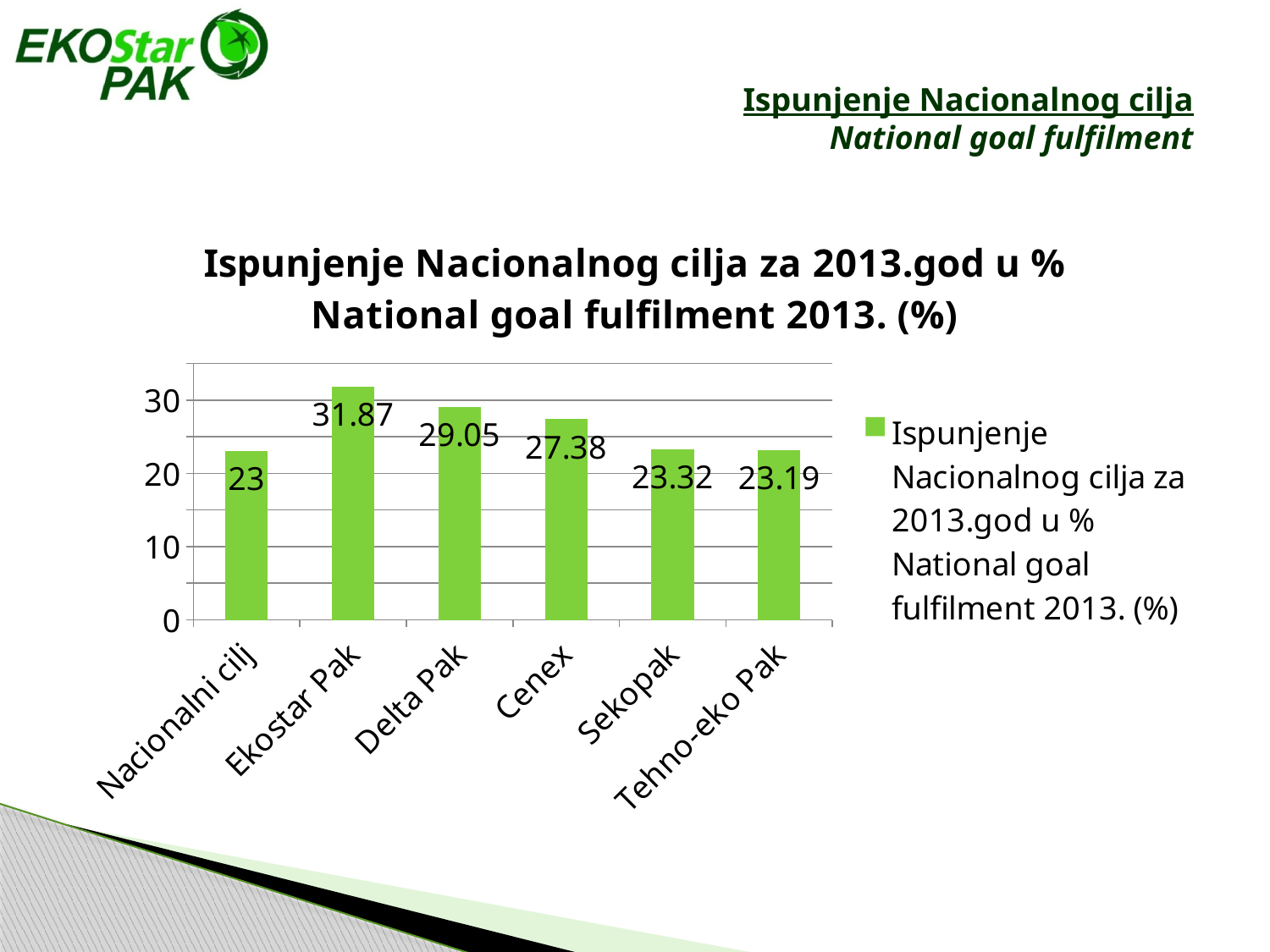
Is the value for Tehno-eko Pak greater or less than 20? greater How many series does the legend list? 1 What is the value for Ekostar Pak? 31.87 What is the difference between the values for Delta Pak and Cenex? 1.67 Which is larger, the value for Delta Pak or the value for Cenex? Delta Pak What kind of chart is shown on the slide? bar chart What is the value for Sekopak? 23.32 How many categories are shown on the x axis? 6 Which category has the lowest value? Nacionalni cilj What is the value for Nacionalni cilj? 23 What is the difference between the values for Ekostar Pak and Nacionalni cilj? 8.87 Which category has the highest value? Ekostar Pak